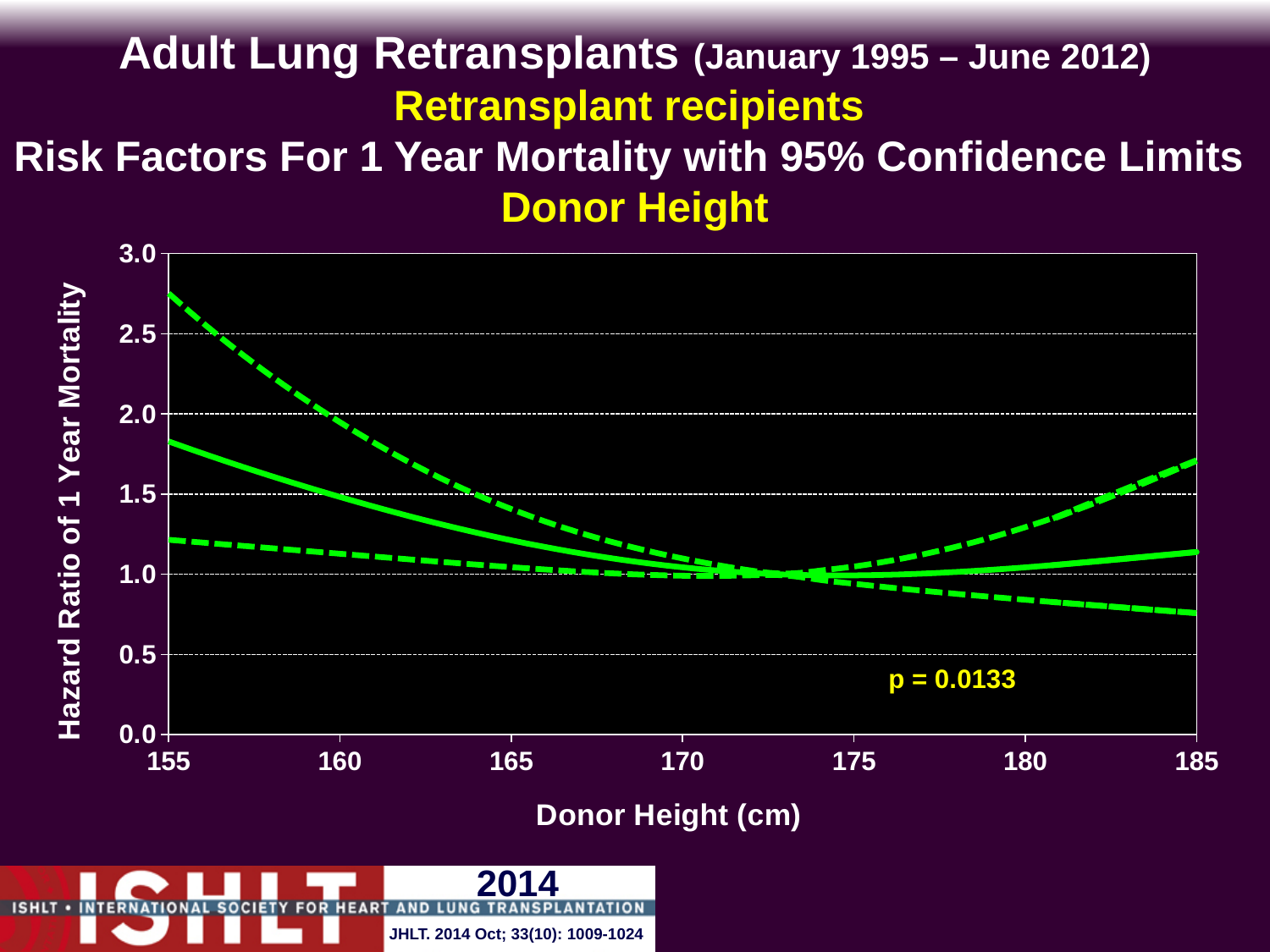
Is the value of the lower dashed line at a donor height of 155 cm greater or less than 1.5? less Is the value of the upper dashed line at a donor height of 185 cm greater or less than 1.5? greater Is the value of the lower dashed line at a donor height of 185 cm greater or less than 1.0? less Does the solid hazard ratio line rise or fall as donor height increases from 155 cm to 170 cm? fall Does the upper dashed confidence limit rise or fall as donor height increases from 175 cm to 185 cm? rise What kind of chart is shown on the slide? line chart How many lines are plotted on the chart? 3 At which donor height, 155 cm or 185 cm, is the solid line higher? 155 cm What p-value is printed on the chart? p = 0.0133 What is the label of the x axis? Donor Height (cm)